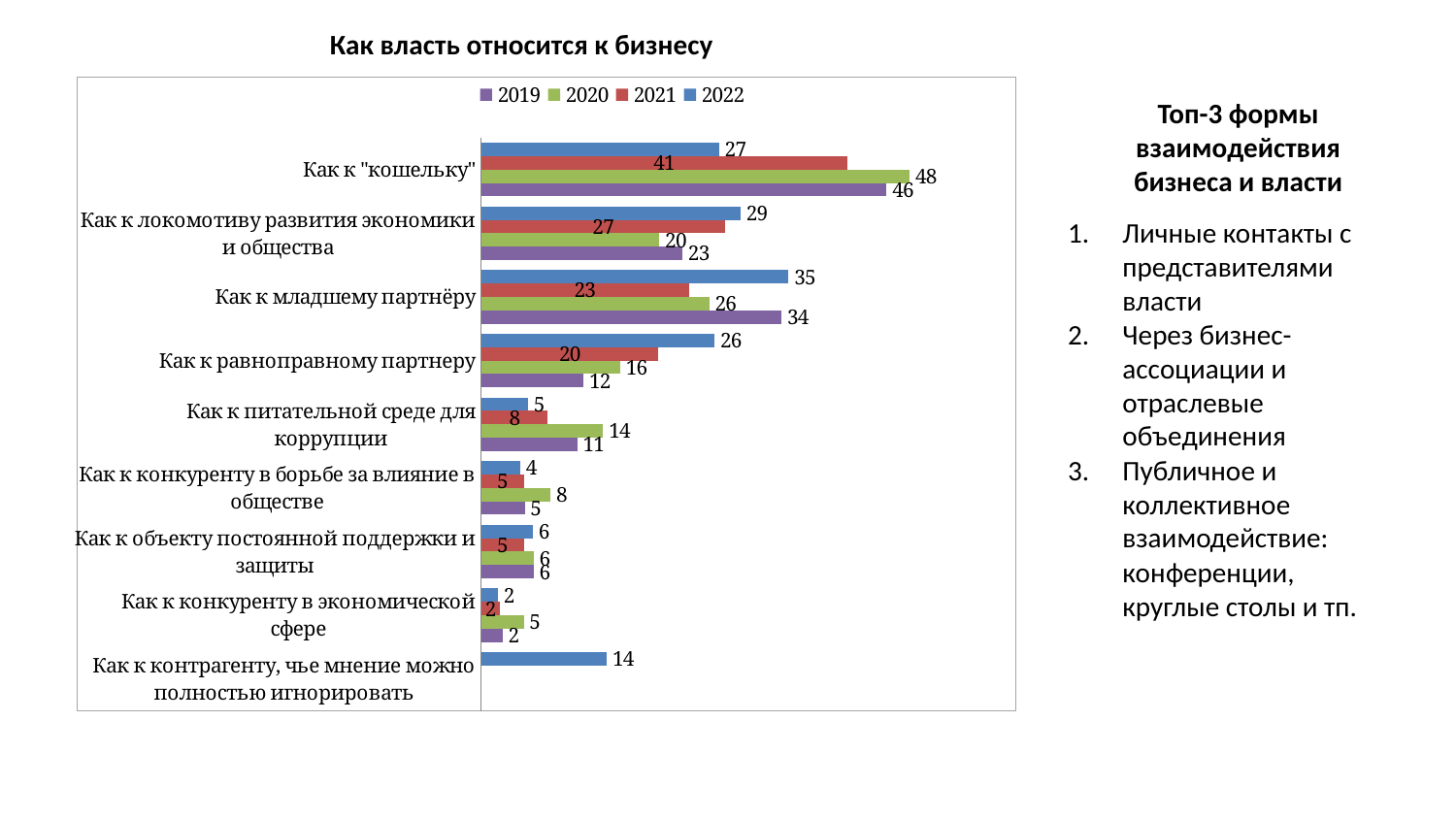
What is the 2020 value for "Как к "кошельку""? 48 What type of chart is shown on the slide? bar chart Which category has the highest 2022 value? Как к младшему партнёру What is the 2022 value for "Как к младшему партнёру"? 35 What is the difference between the 2020 and 2022 values for "Как к "кошельку""? 21 What is the 2022 value for "Как к контрагенту, чье мнение можно полностью игнорировать"? 14 How many categories are shown on the chart? 9 How many series does the chart legend list? 4 For "Как к равноправному партнеру", which is larger: the 2019 value or the 2022 value? 2022 What is the title of the chart? Как власть относится к бизнесу Which category has the lowest 2019 value? Как к конкуренту в экономической сфере What is the 2021 value for "Как к локомотиву развития экономики и общества"? 27